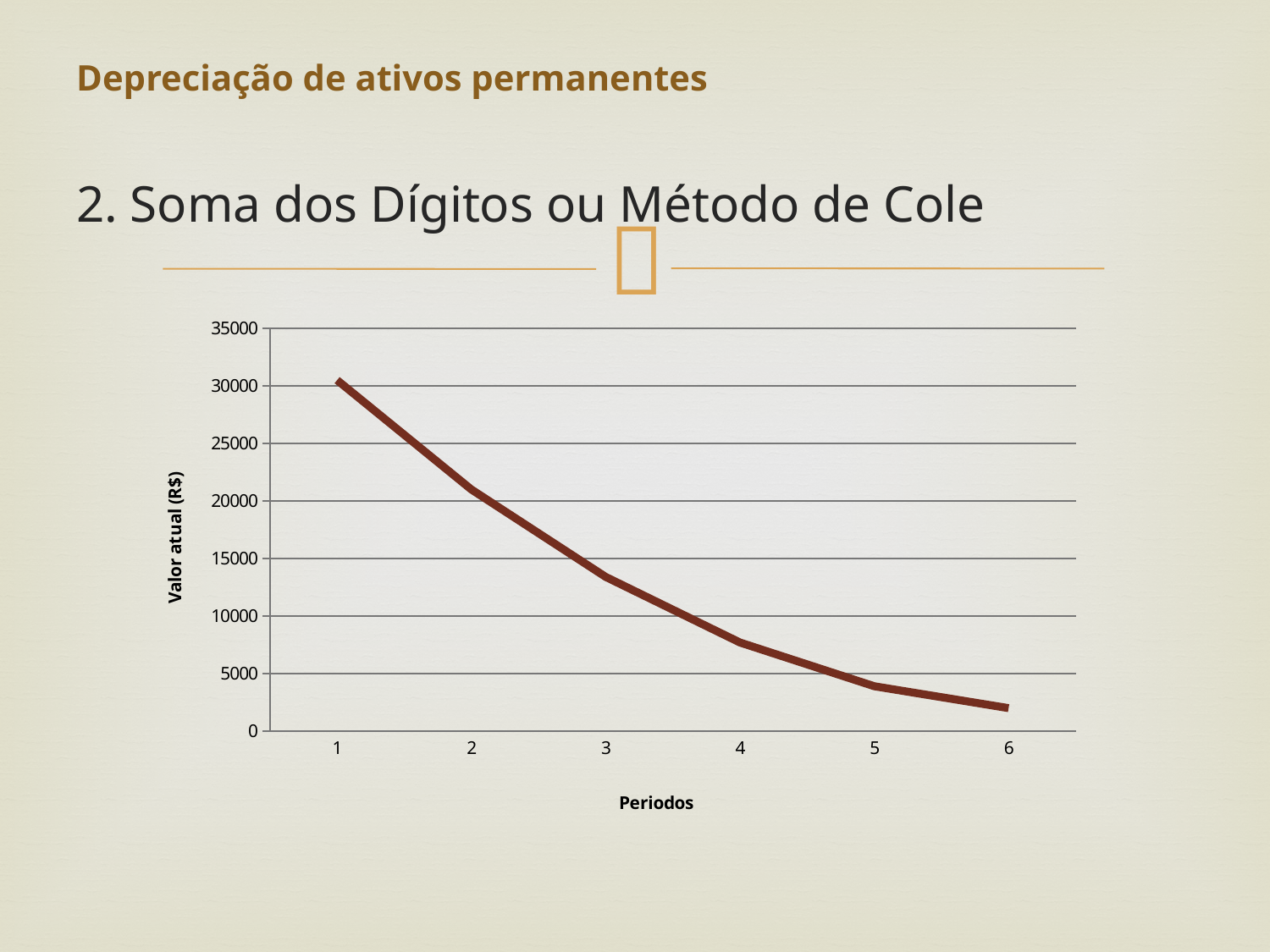
What is the title of the vertical axis? Valor atual (R$) Which is larger, the value for period 2 or the value for period 4? period 2 Do the values rise or fall as the period increases from 1 to 6? fall Which period has the highest value? 1 What kind of chart is shown on the slide? line chart Is the value for period 4 greater or less than 10000? less Is the value for period 3 greater or less than 15000? less Is the value for period 2 greater or less than 20000? greater Which period has the lowest value? 6 How many periods are plotted on the x axis? 6